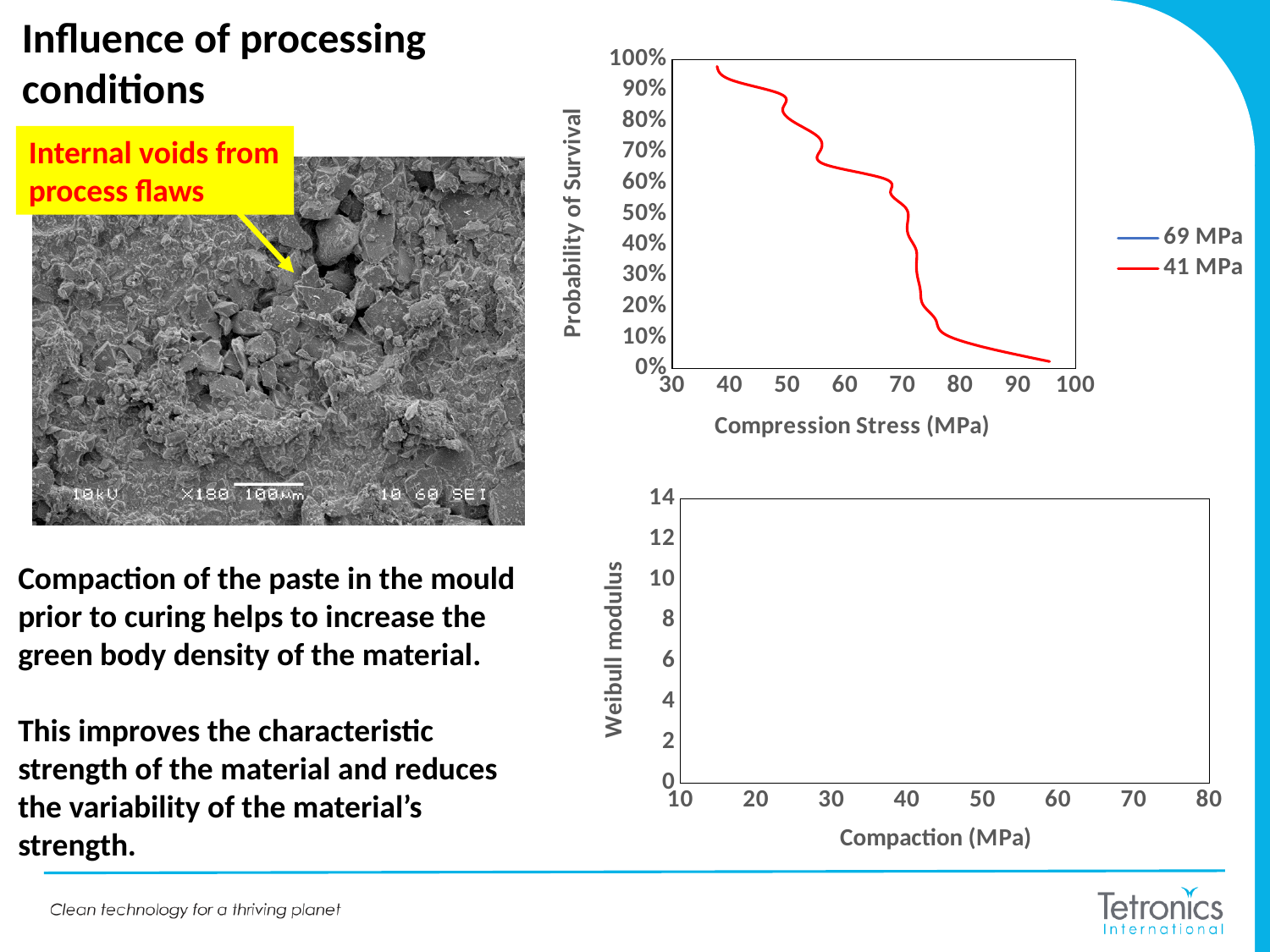
In the top chart, is the probability of survival for the 41 MPa series at a compression stress of 80 MPa greater or less than 50%? less In the bottom chart (Weibull modulus vs Compaction), how many data points are plotted? 0 In the top chart, how many series does the legend list? 2 In the top chart, is the probability of survival for the 41 MPa series at a compression stress of 50 MPa greater or less than 50%? greater What kind of chart is the top chart on the slide (Probability of Survival vs Compression Stress)? line chart In the top chart, is the probability of survival for the 41 MPa series at a compression stress of 40 MPa greater or less than 80%? greater In the top chart, does the probability of survival for the 41 MPa series rise or fall as compression stress increases? fall What is the x-axis title of the bottom chart on the slide? Compaction (MPa) In the top chart, what are the two series named in the legend? 69 MPa and 41 MPa